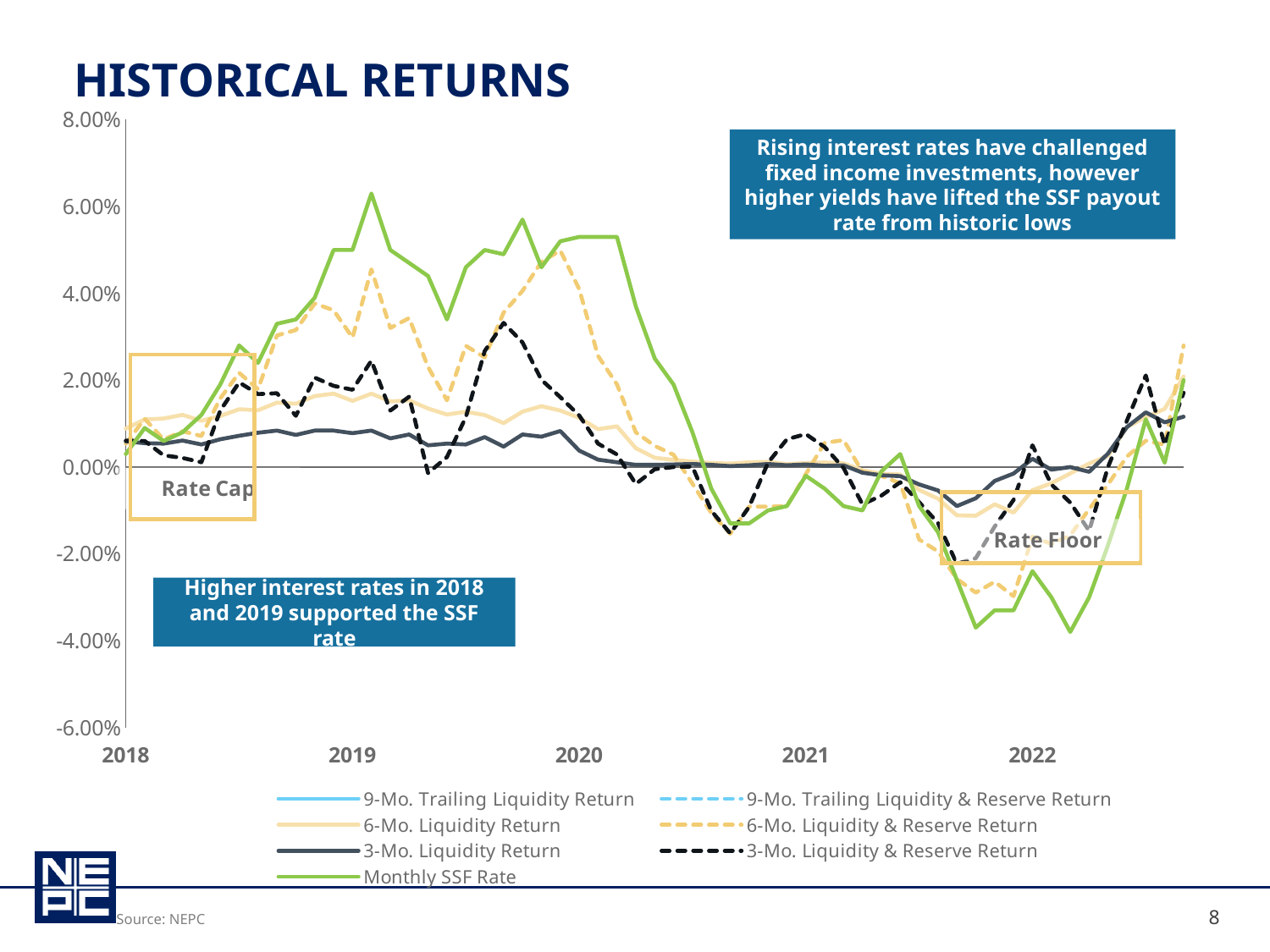
What kind of chart is shown on the slide? line chart Does the Monthly SSF Rate rise or fall between the start of 2020 and the start of 2021? fall Is the highest value of the Monthly SSF Rate in 2019 greater or less than 4.00%? greater What is the highest value shown on the y axis? 8.00% Does the Monthly SSF Rate rise or fall between the start of 2018 and the start of 2019? rise How many year labels are shown on the x axis? 5 What is the title of the chart? HISTORICAL RETURNS Is the highest value of the 3-Mo. Liquidity Return greater or less than 2.00%? less Which series reaches the highest value on the chart, Monthly SSF Rate or 3-Mo. Liquidity Return? Monthly SSF Rate How many series does the legend list? 7 Is the lowest value of the Monthly SSF Rate in 2022 greater or less than -2.00%? less